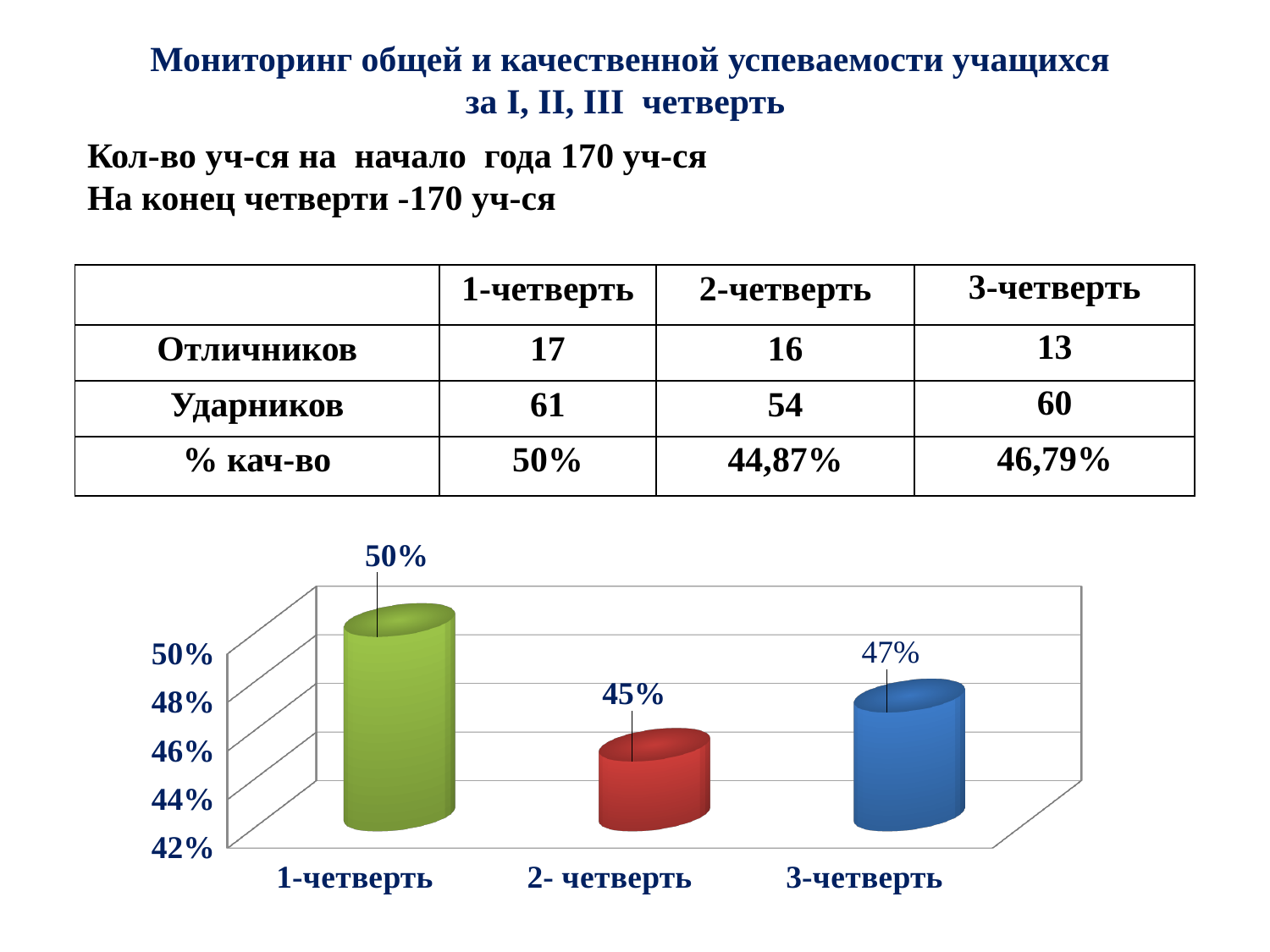
Which is larger in the chart, the value for 3-четверть or the value for 2- четверть? 3-четверть What colour is the bar for 1-четверть in the chart? green What is the difference between the values for 3-четверть and 2- четверть in the chart? 2% What value is shown for 1-четверть in the chart? 50% What value is shown for 3-четверть in the chart? 47% Which quarter has the lowest value in the chart? 2- четверть What kind of chart is shown on the slide? bar chart What value is shown for 2- четверть in the chart? 45% What is the difference between the values for 1-четверть and 2- четверть in the chart? 5% Is the value for 2- четверть greater or less than 46%? less Which quarter has the highest value in the chart? 1-четверть How many categories are plotted in the chart? 3